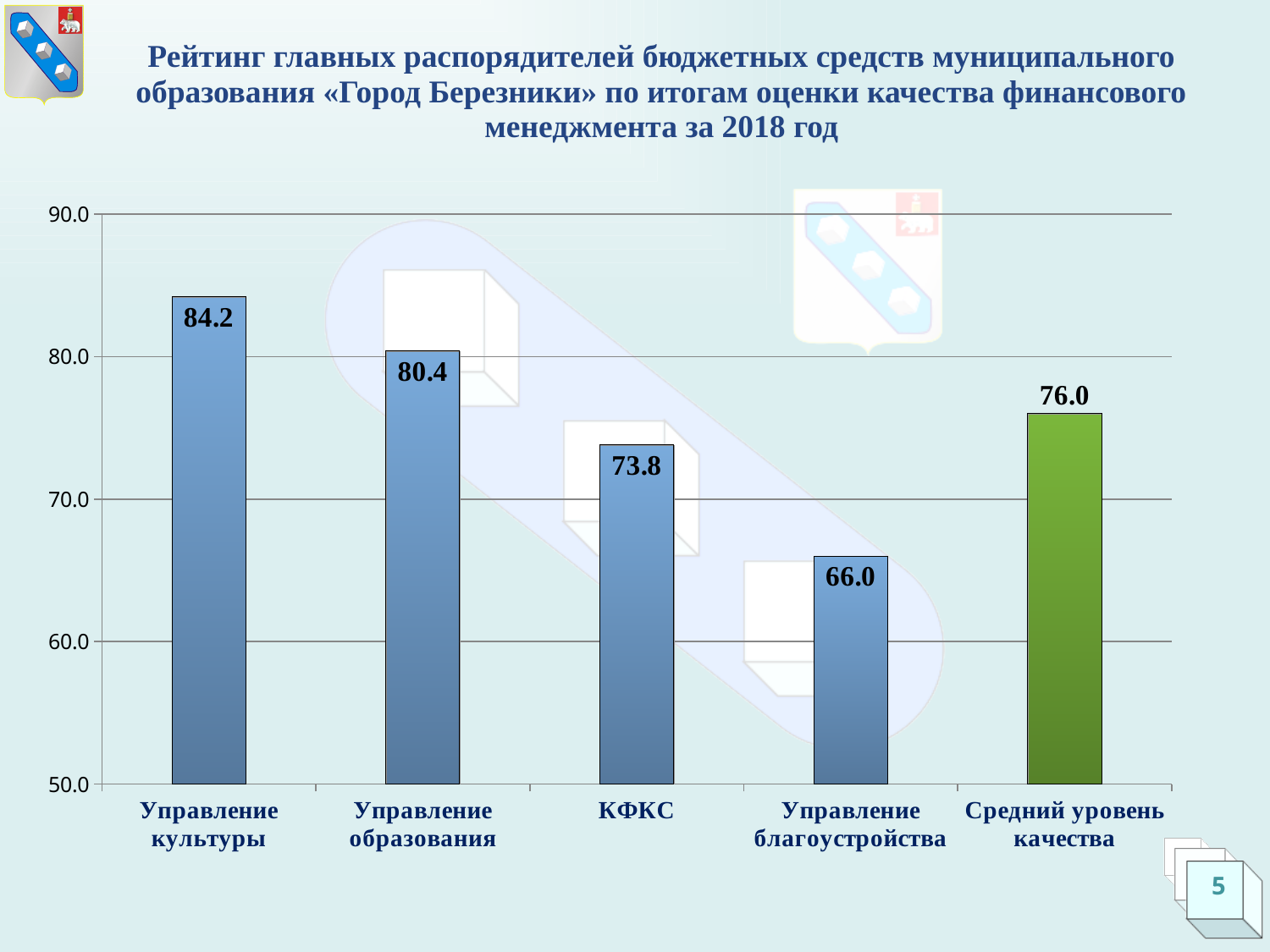
How many categories are shown on the chart? 5 Is the value for Управление благоустройства greater or less than 70.0? less Which category has the highest value? Управление культуры Which bar is coloured green rather than blue? Средний уровень качества Which category has the lowest value? Управление благоустройства What is the value for Управление культуры? 84.2 What is the value for КФКС? 73.8 Which is larger, the value for КФКС or the value for Средний уровень качества? Средний уровень качества What is the difference between the values for Управление образования and Управление благоустройства? 14.4 What is the value for Средний уровень качества? 76.0 What is the difference between the values for Управление культуры and Управление образования? 3.8 What kind of chart is shown on the slide? bar chart